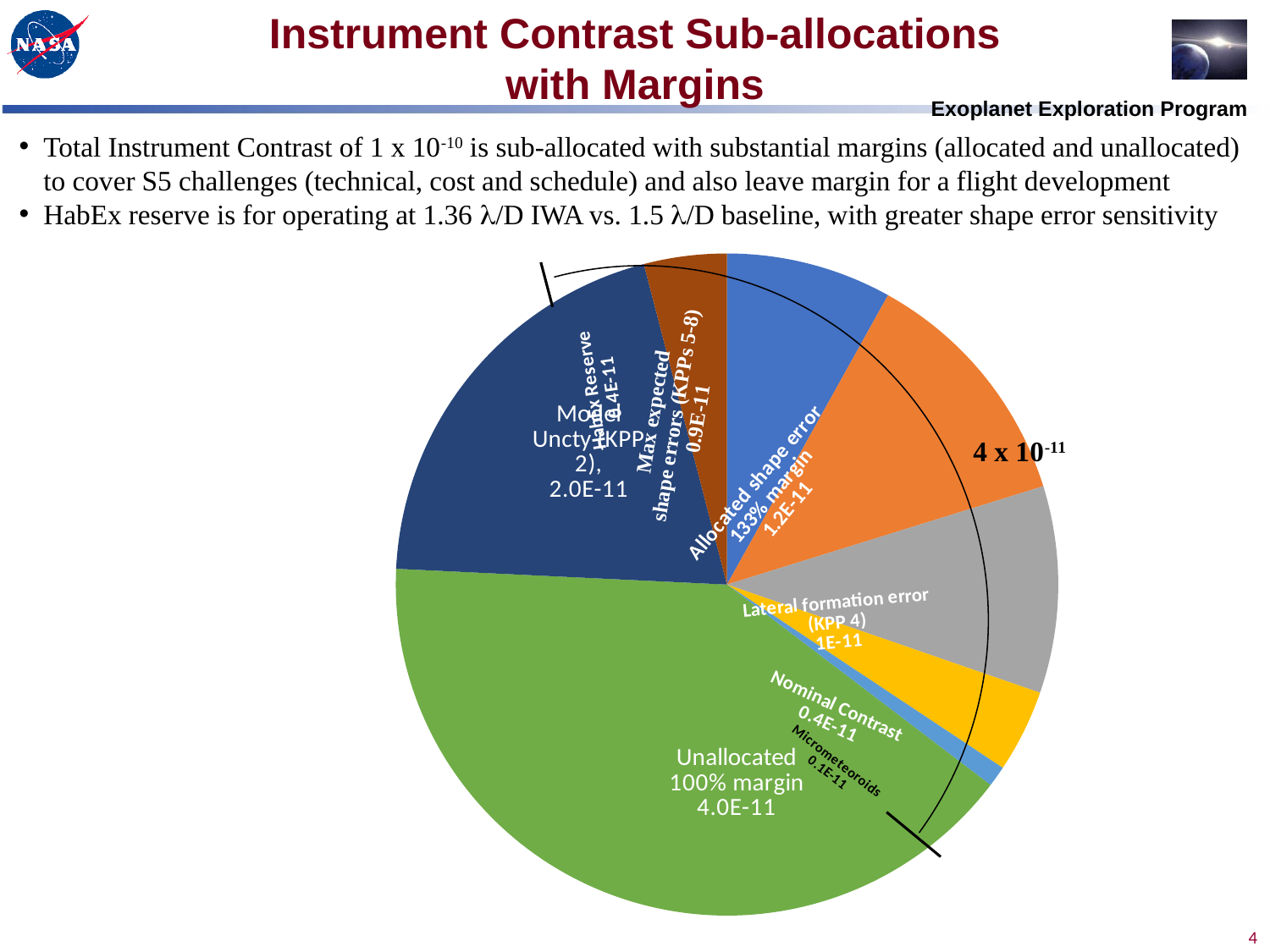
What value is shown for the Max expected shape errors (KPPs 5-8) slice? 0.9E-11 What value is shown for the Micrometeoroids slice? 0.1E-11 Which slice of the pie is the largest? Unallocated 100% margin What value is shown for the HabEx Reserve slice? 0.4E-11 What is the difference between the Unallocated 100% margin value and the Model Uncty (KPP 2) value? 2.0E-11 What value is shown for the Lateral formation error (KPP 4) slice? 1E-11 What value is shown for the Unallocated 100% margin slice? 4.0E-11 What kind of chart is shown on the slide? pie chart What value is shown for the Nominal Contrast slice? 0.4E-11 What value is shown for the Model Uncty (KPP 2) slice? 2.0E-11 Which is larger, the Model Uncty (KPP 2) slice or the Lateral formation error (KPP 4) slice? Model Uncty (KPP 2) Which slice of the pie is the smallest? Micrometeoroids